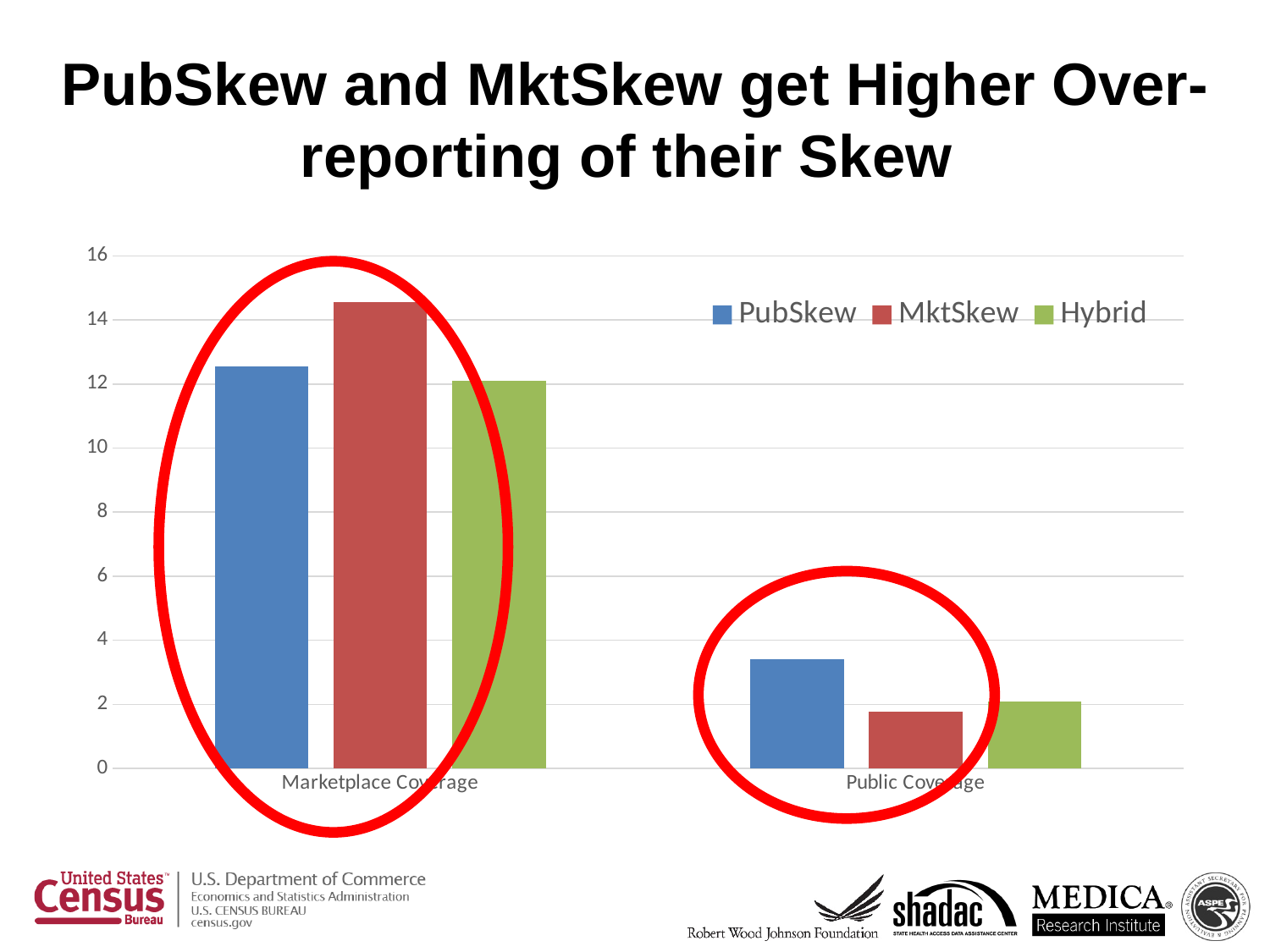
For Public Coverage, which is larger: the PubSkew value or the MktSkew value? PubSkew Is the MktSkew value for Marketplace Coverage greater or less than 14? greater Which series is shown in green in the chart legend? Hybrid How many series does the chart legend list? 3 Which series has the highest value for Marketplace Coverage? MktSkew Is the PubSkew value for Marketplace Coverage greater or less than 12? greater Which series has the highest value for Public Coverage? PubSkew Which series has the lowest value for Marketplace Coverage? Hybrid How many categories are shown on the x axis of the chart? 2 Is the PubSkew value for Public Coverage greater or less than 4? less What kind of chart is shown on the slide? bar chart